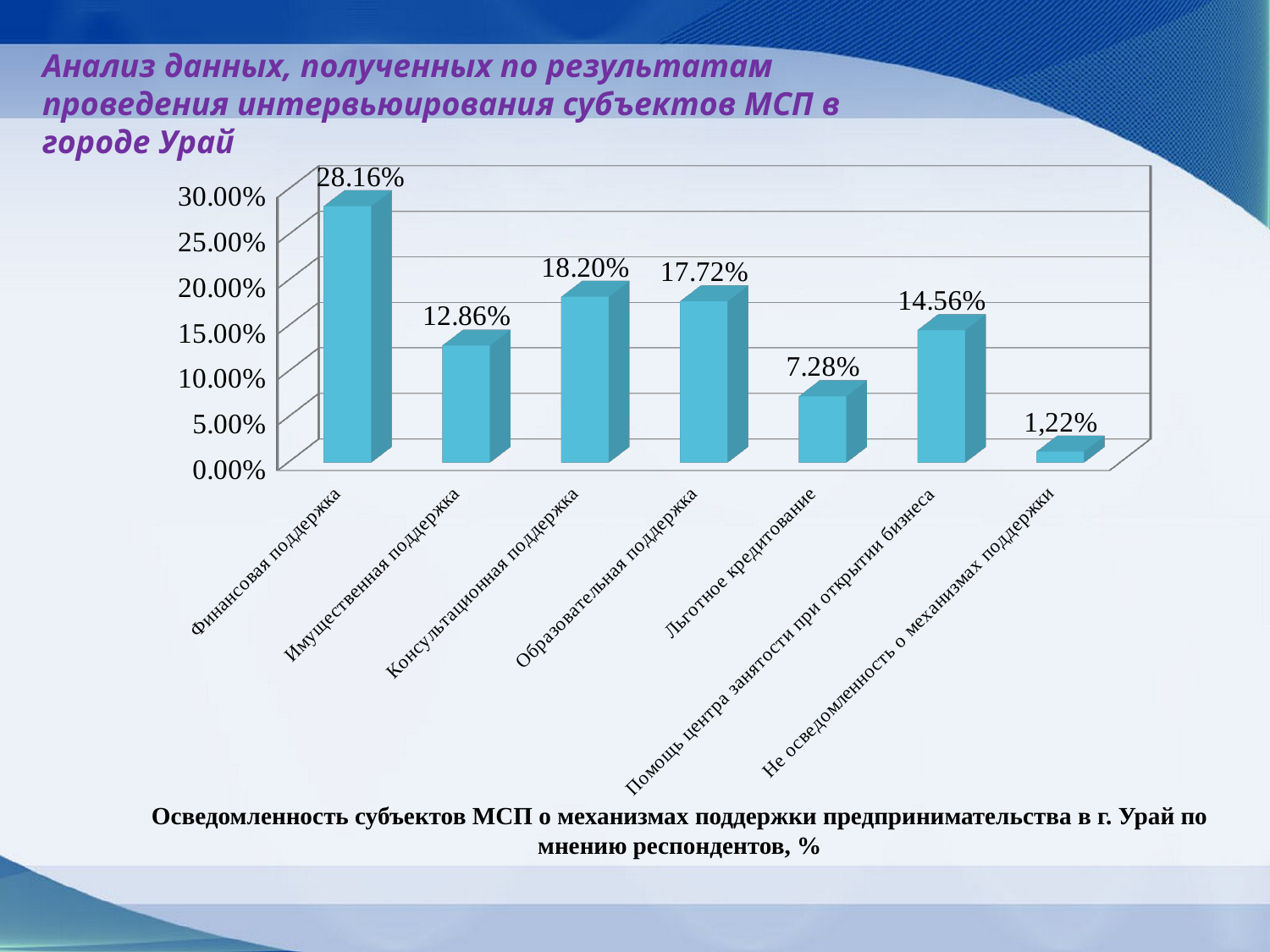
What is the value for Льготное кредитование? 7.28% What is the caption printed below the chart? Осведомленность субъектов МСП о механизмах поддержки предпринимательства в г. Урай по мнению респондентов, % What is the difference between the values for Финансовая поддержка and Имущественная поддержка? 15.30% How many categories are shown in the chart? 7 What is the value for Помощь центра занятости при открытии бизнеса? 14.56% What kind of chart is shown on the slide? bar chart What is the value for Финансовая поддержка? 28.16% Which category has the lowest value? Не осведомленность о механизмах поддержки Which is larger: the value for Образовательная поддержка or the value for Помощь центра занятости при открытии бизнеса? Образовательная поддержка Which category has the highest value? Финансовая поддержка What is the value for Не осведомленность о механизмах поддержки? 1,22% What is the value for Консультационная поддержка? 18.20%